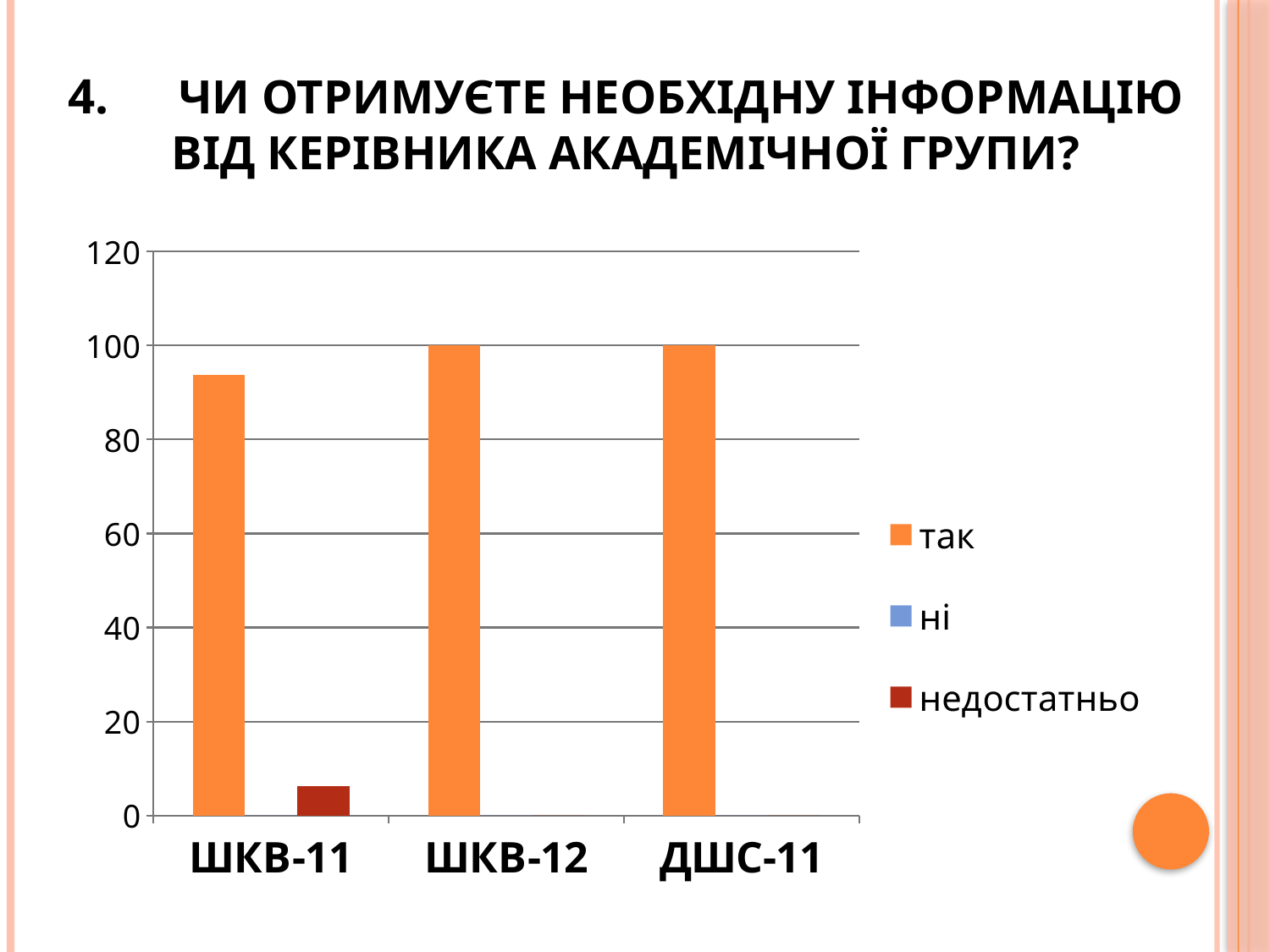
Is the value of the "недостатньо" bar for ШКВ-11 greater or less than 20? less Is the value of the "так" bar for ШКВ-11 greater or less than 80? greater What kind of chart is shown on the slide? bar chart Which category is the only one with a visible bar for the "недостатньо" series? ШКВ-11 Which category has the lowest value for the "так" series? ШКВ-11 How many categories are shown on the x axis of the chart? 3 What is the value of the "так" bar for ШКВ-12? 100 What are the three entries listed in the chart's legend? так, ні, недостатньо How many series does the chart's legend list? 3 Is the value of the "так" bar for ШКВ-11 greater or less than 100? less What is the value of the "так" bar for ДШС-11? 100 Which is larger: the "так" value for ШКВ-11 or the "так" value for ШКВ-12? ШКВ-12